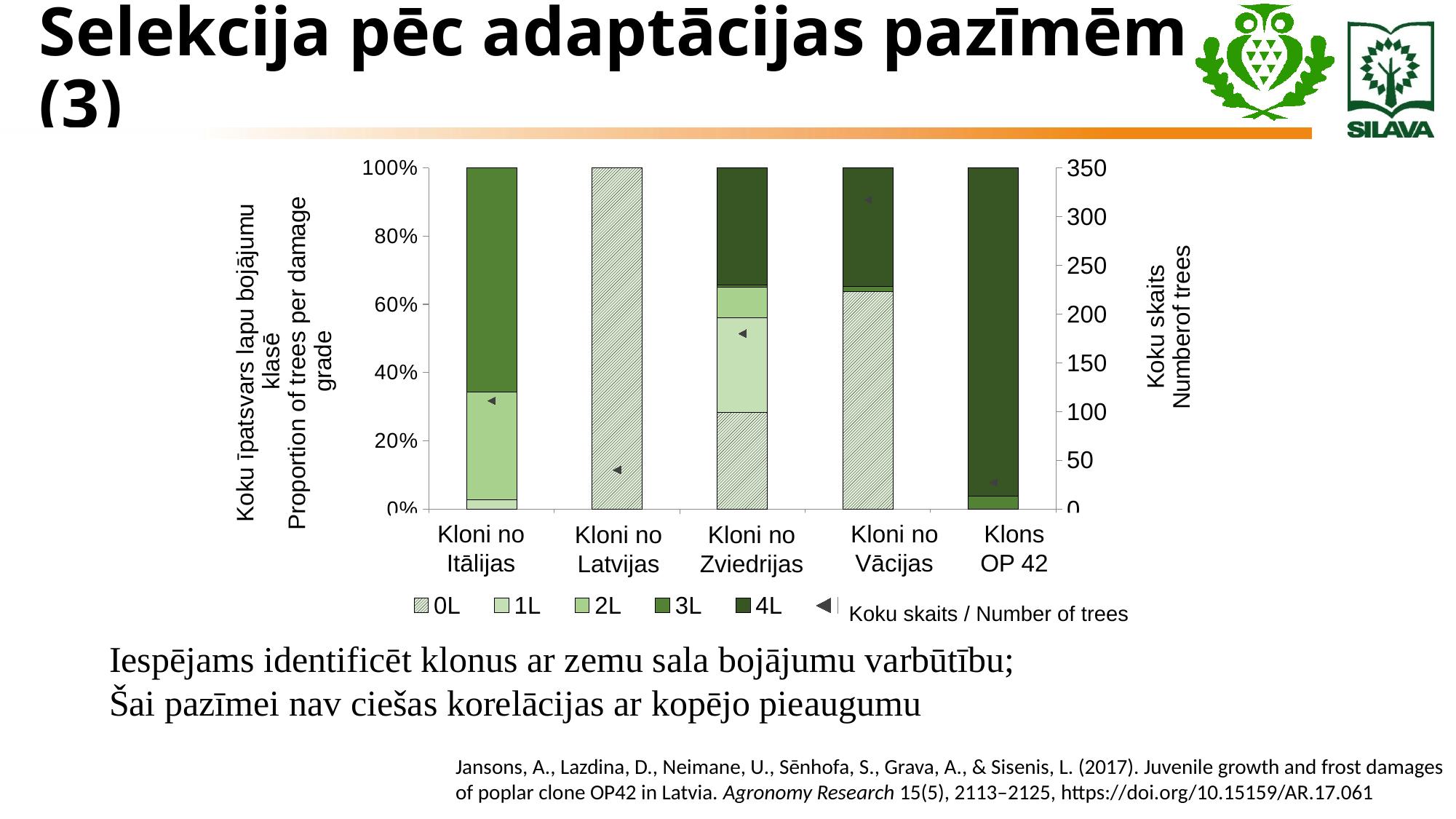
Is the proportion of 0L trees for Kloni no Vācijas greater or less than 60%? greater Is the proportion of 4L trees for Kloni no Zviedrijas greater or less than 20%? greater Is the proportion of 0L trees for Kloni no Latvijas greater or less than 80%? greater How many entries does the legend list? 6 Which clone group has the highest number of trees (Koku skaits marker)? Kloni no Vācijas What kind of chart is shown on the slide? stacked bar chart Which has more trees, Kloni no Zviedrijas or Kloni no Itālijas? Kloni no Zviedrijas What is the title of the right-hand (secondary) y axis? Koku skaits / Number of trees How many clone groups (categories) are shown on the x axis? 5